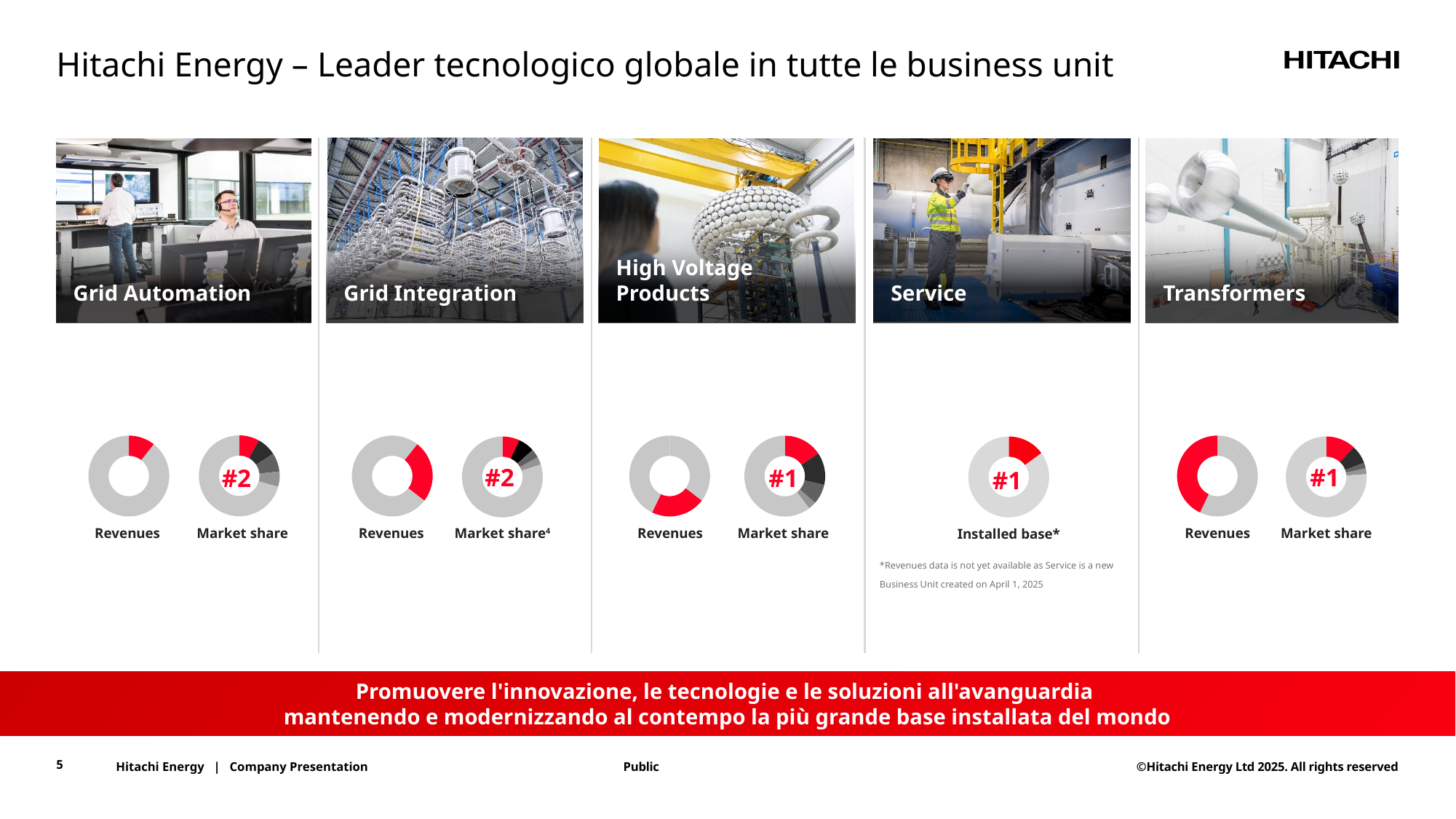
What market share ranking is shown in the Grid Automation Market share chart? #2 What ranking is shown in the Transformers Market share chart? #1 How many business units on the slide show a Market share chart? 4 Is the red revenue share larger for Transformers or for Grid Automation? Transformers Why does the Service business unit show an Installed base chart instead of a Revenues chart? Revenues data is not yet available as Service is a new Business Unit created on April 1, 2025 Which business unit's Revenues chart shows the smallest red share? Grid Automation What ranking is shown in the Service Installed base chart? #1 Which business unit's Revenues chart shows the largest red share? Transformers What market share ranking is shown in the Grid Integration Market share chart? #2 What kind of chart is used to show Revenues under Grid Automation? pie chart (donut) How many business units on the slide are ranked #1? 3 What market share ranking is shown in the High Voltage Products Market share chart? #1